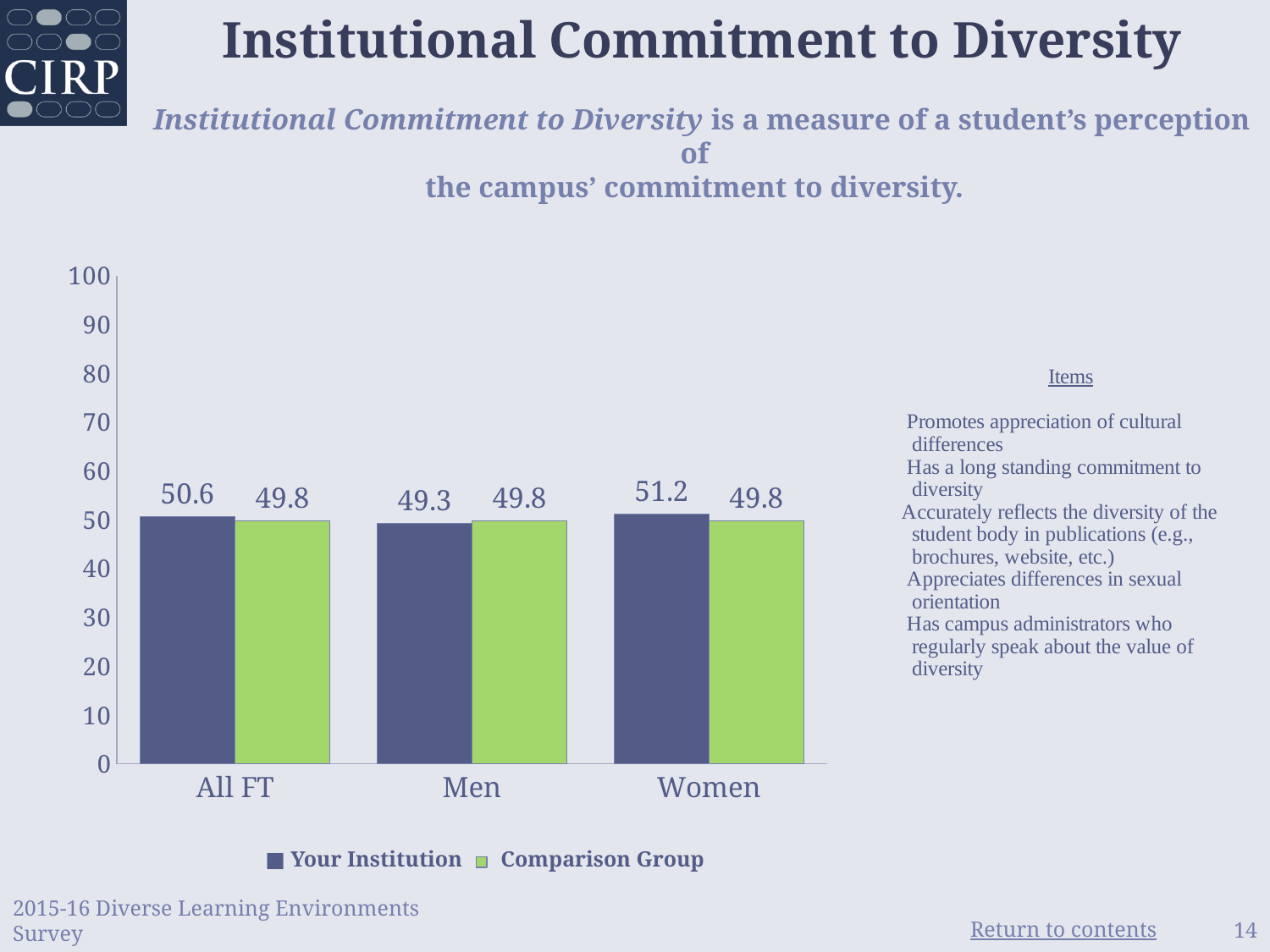
What is the value for Your Institution in the Men category? 49.3 What is the value for Your Institution in the All FT category? 50.6 How many categories are shown on the x axis? 3 What is the difference between the Your Institution value and the Comparison Group value in the All FT category? 0.8 How many series does the legend list? 2 Which category has the lowest value for Your Institution? Men What is the value for Your Institution in the Women category? 51.2 In the Men category, which is larger: Your Institution or Comparison Group? Comparison Group What is the value for the Comparison Group in the Women category? 49.8 Which category has the highest value for Your Institution? Women What kind of chart is shown on the slide? Bar chart What is the difference between the Your Institution value for Women and the Your Institution value for Men? 1.9